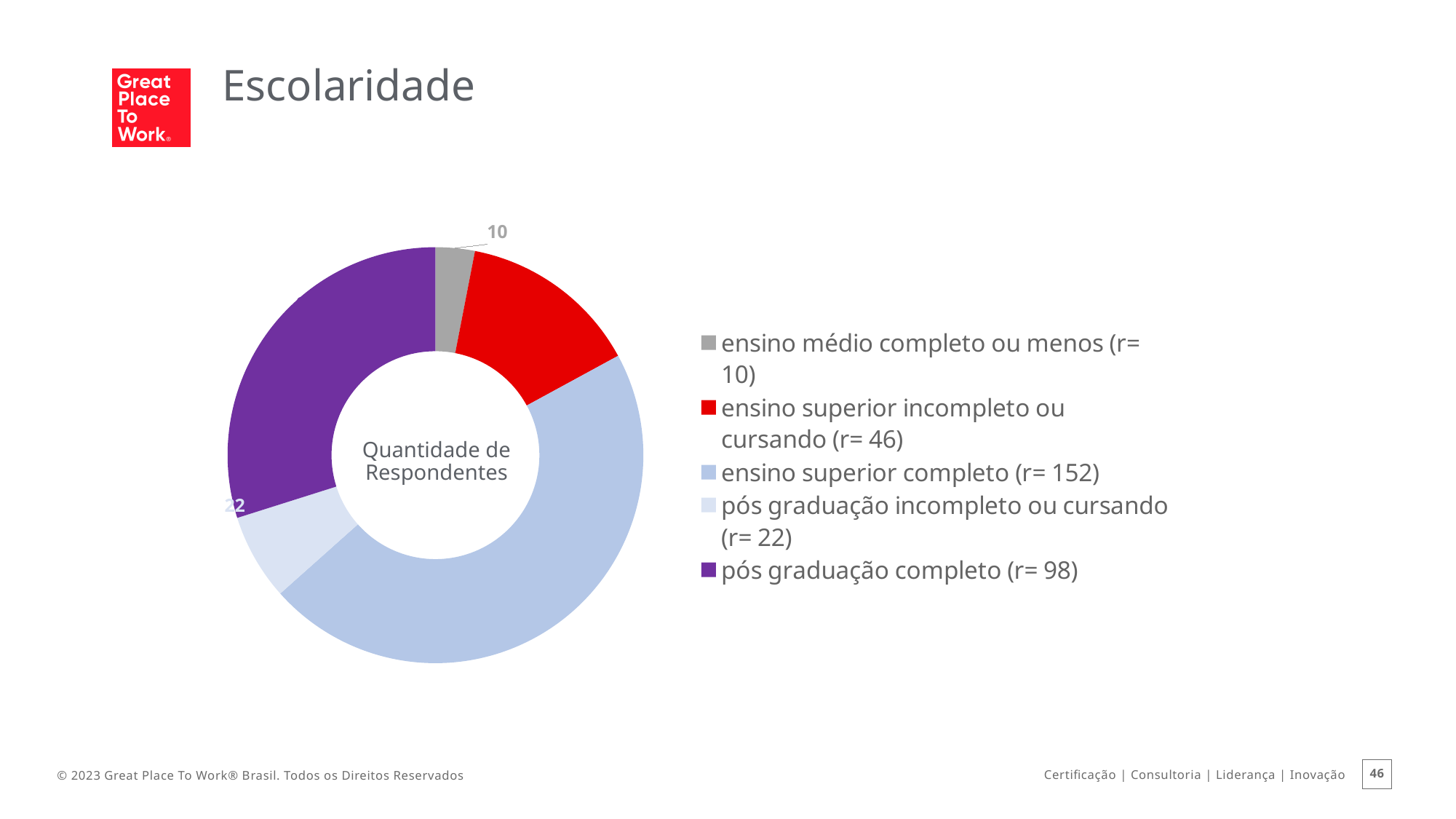
Which has more respondents: 'ensino superior incompleto ou cursando' or 'pós graduação incompleto ou cursando'? ensino superior incompleto ou cursando How many categories does the chart show? 5 What kind of chart is shown on the slide? Pie (donut) chart What is the total number of respondents across all categories? 328 How many respondents are in the 'ensino médio completo ou menos' category? 10 What text appears in the centre of the donut chart? Quantidade de Respondentes Which category has the smallest number of respondents? ensino médio completo ou menos How many respondents have 'ensino superior completo' according to the legend? 152 Which category has the largest number of respondents? ensino superior completo What is the value for 'ensino superior incompleto ou cursando'? 46 What is the r value for 'pós graduação completo'? 98 What is the difference between the number of respondents with 'ensino superior completo' and those with 'pós graduação completo'? 54